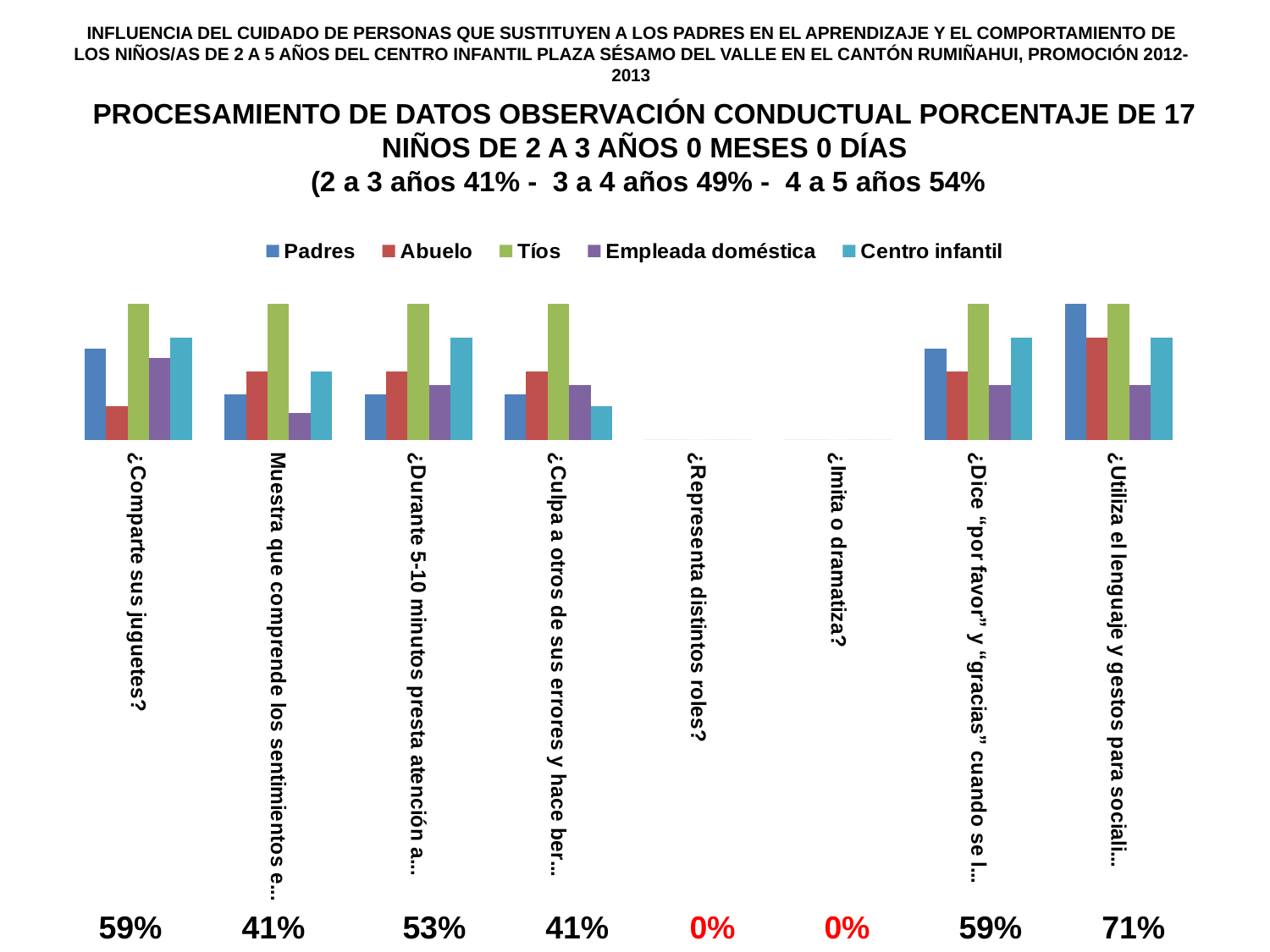
Which series has the tallest bar for the category '¿Comparte sus juguetes?'? Tíos Which series has the shortest bar for the category '¿Culpa a otros de sus errores y hace ber...'? Centro infantil Which colour represents the series 'Tíos' in the legend? green What kind of chart is shown on the slide? bar chart How many categories on the chart have no bars at all? 2 What percentage is printed below the category '¿Utiliza el lenguaje y gestos para sociali...'? 71% For the category '¿Comparte sus juguetes?', which is larger: the bar for Padres or the bar for Centro infantil? Centro infantil Which series has the shortest bar for the category '¿Comparte sus juguetes?'? Abuelo How many series does the legend list? 5 Which series has the tallest bar for the category '¿Dice "por favor" y "gracias" cuando se l...'? Tíos How many categories are shown along the x axis of the chart? 8 For the category 'Muestra que comprende los sentimientos e...', which is larger: the bar for Padres or the bar for Abuelo? Abuelo